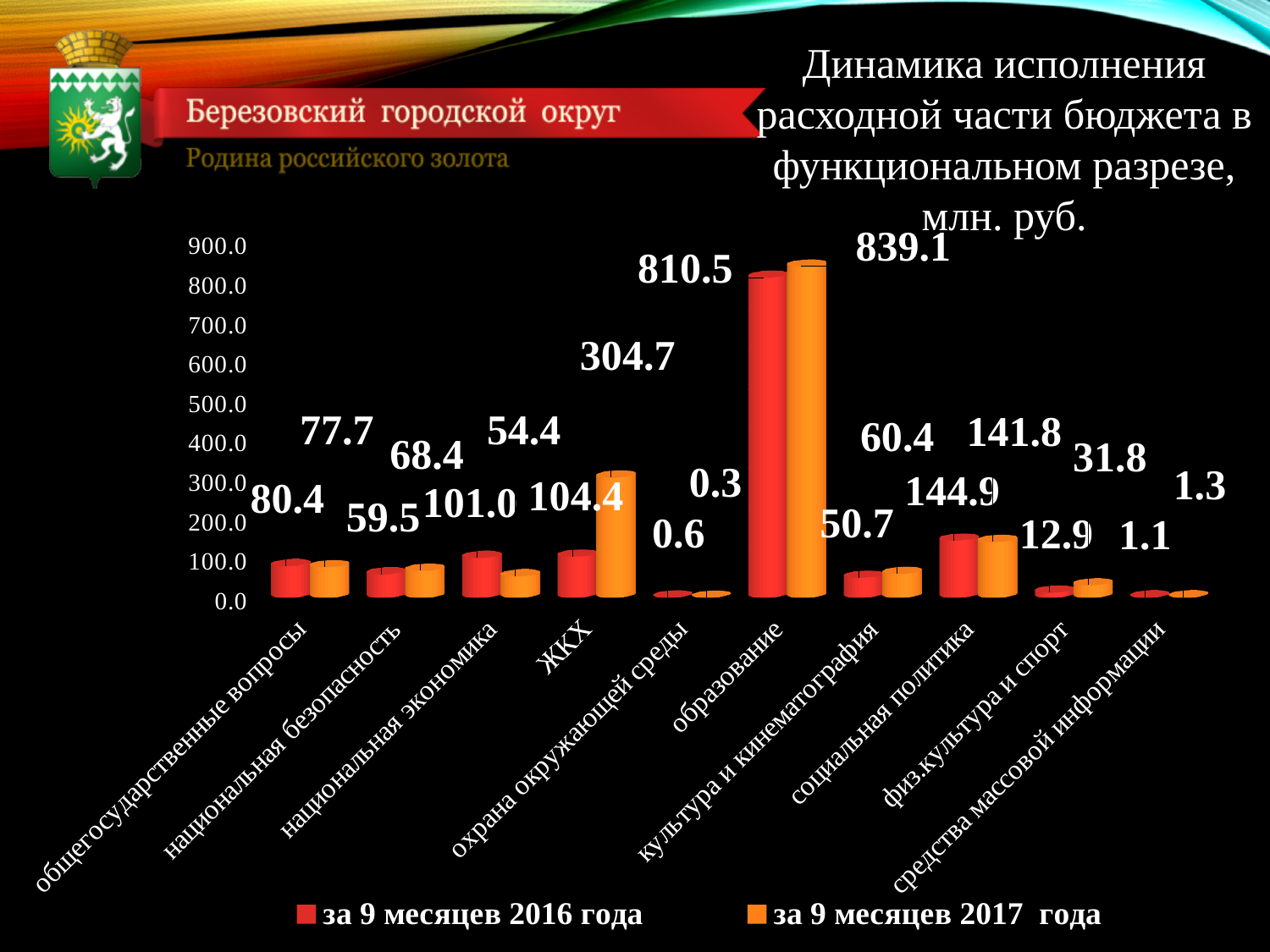
Is the value for образование for за 9 месяцев 2016 года greater or less than 800.0? greater What is the value for образование for за 9 месяцев 2017 года? 839.1 How many series does the chart legend list? 2 How many categories are shown on the x axis of the chart? 10 What is the value for ЖКХ for за 9 месяцев 2016 года? 104.4 Which category has the highest value for за 9 месяцев 2016 года? образование Which category has the lowest value for за 9 месяцев 2017 года? охрана окружающей среды What is the difference between the 2017 and 2016 values for ЖКХ? 200.3 What type of chart is shown on the slide? bar chart What is the value for социальная политика for за 9 месяцев 2017 года? 141.8 For национальная экономика, which series has the larger value: за 9 месяцев 2016 года or за 9 месяцев 2017 года? за 9 месяцев 2016 года What unit of measurement is stated in the chart title? млн. руб.